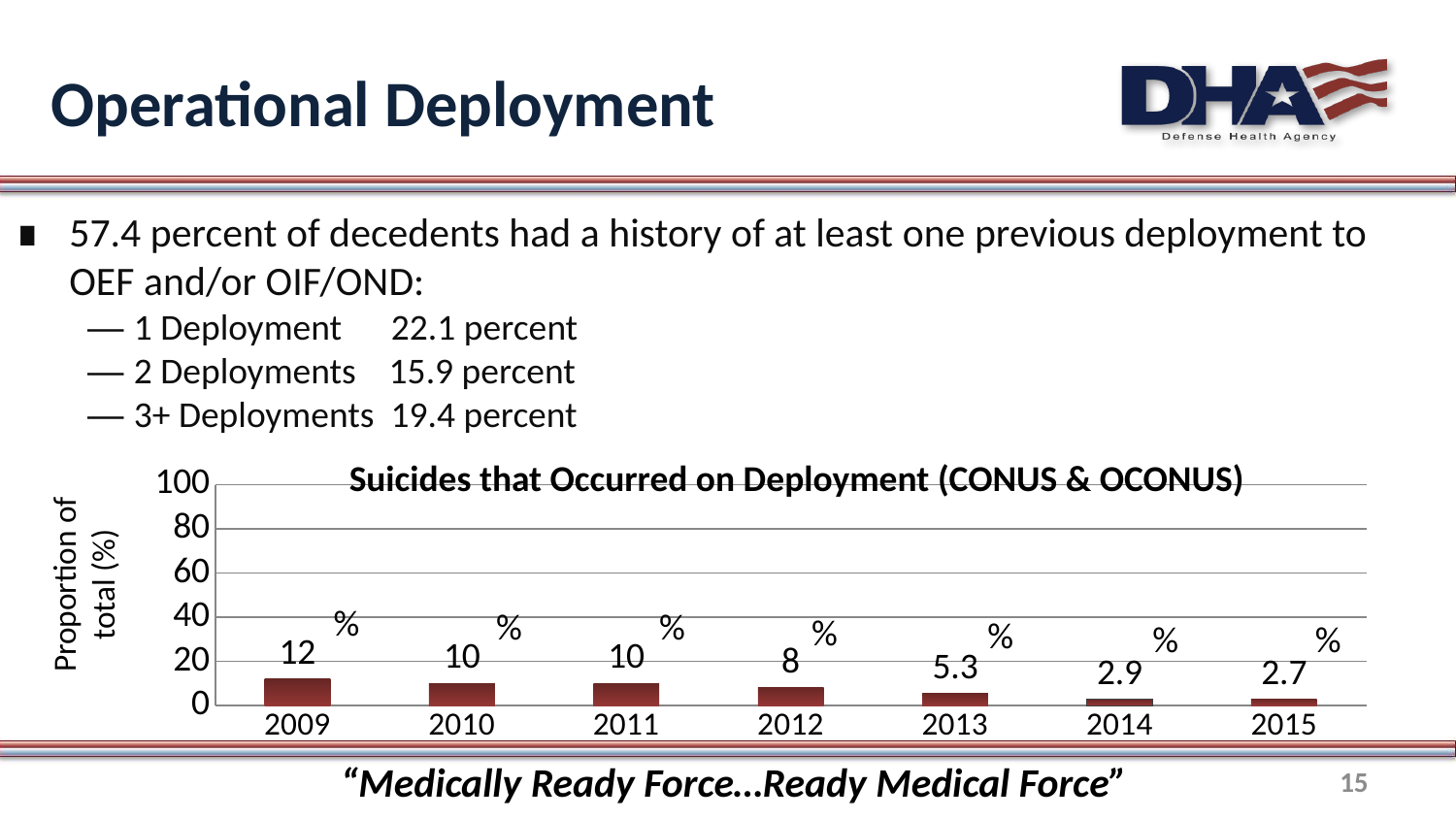
What kind of chart is shown on the slide? bar chart What is the value for 2015 in the chart? 2.7% Is the value for 2009 greater or less than 20? less How many years are shown on the x axis of the chart? 7 Which is larger, the value for 2012 or the value for 2014? 2012 Do the values rise or fall from 2009 to 2015? fall What is the difference between the values for 2009 and 2012? 4% What is the value for 2013 in the chart? 5.3% What is the difference between the values for 2013 and 2014? 2.4% What is the value for 2009 in the chart? 12% Which year has the lowest value in the chart? 2015 Which year has the highest value in the chart? 2009